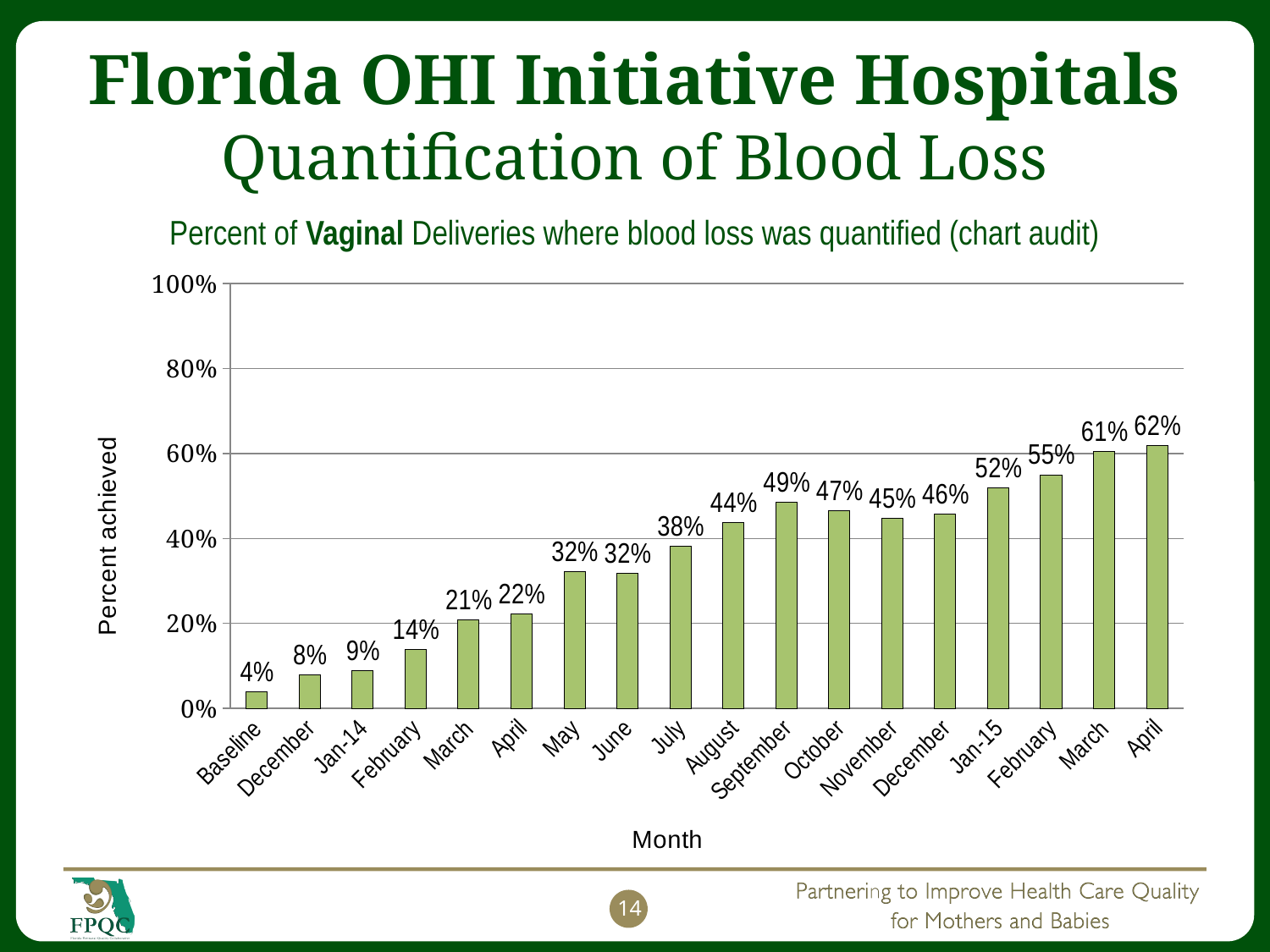
What is the value for Baseline? 4% What is the value for Jan-14? 9% How many bars are plotted in the chart? 18 What is the value for Jan-15? 52% What kind of chart is shown? Bar chart Which month has the highest value? April (the last bar) Do the values generally rise or fall from Baseline to the final April? Rise What is the difference between the values for September and October? 2% Which category has the lowest value? Baseline What is the label of the y axis? Percent achieved Which is larger, the value for July or the value for November? November What is the value for September? 49%